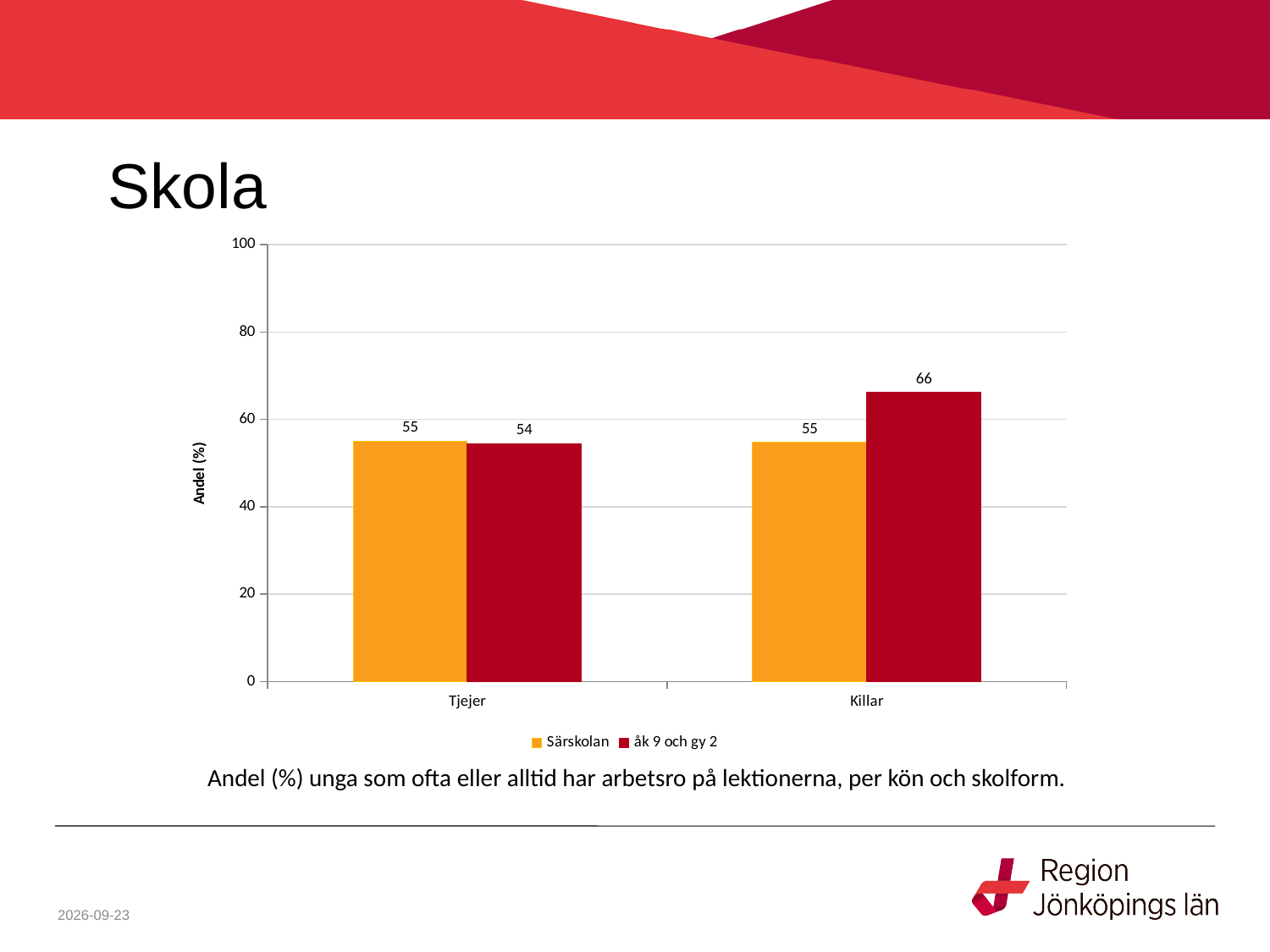
Is the value for åk 9 och gy 2 in the Killar category greater or less than 60? greater What is the value for Särskolan in the Tjejer category? 55 What is the value for åk 9 och gy 2 in the Killar category? 66 Which bar has the highest value on the chart? åk 9 och gy 2 for Killar How many series does the legend list? 2 How many categories are shown on the x axis? 2 What is the difference between the åk 9 och gy 2 value for Killar and the Särskolan value for Killar? 11 Which is larger for Killar: Särskolan or åk 9 och gy 2? åk 9 och gy 2 What kind of chart is shown on the slide? Bar chart What is the value for åk 9 och gy 2 in the Tjejer category? 54 What is the difference between the åk 9 och gy 2 values for Killar and Tjejer? 12 What is the value for Särskolan in the Killar category? 55